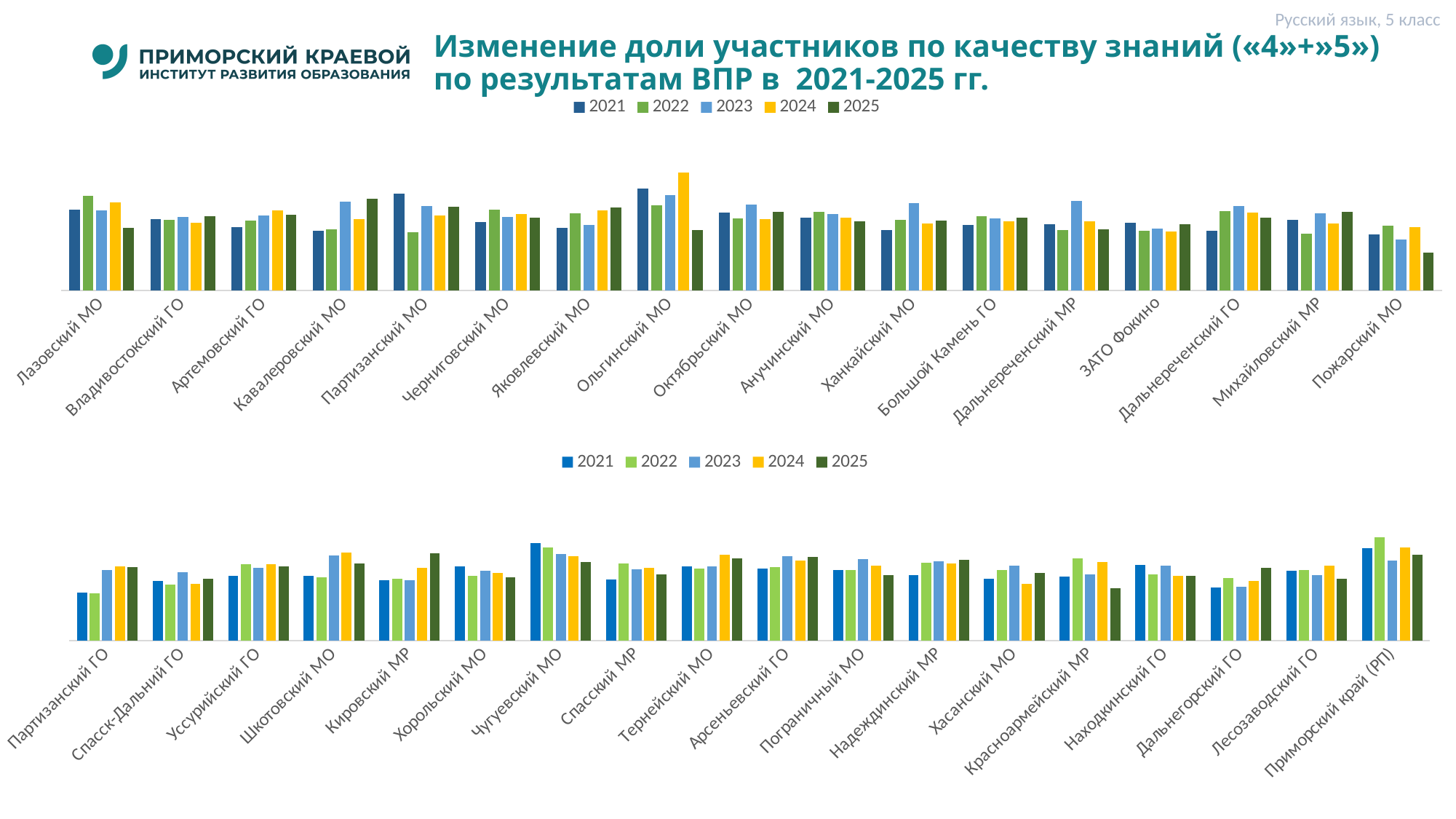
In the bottom chart, which year has the highest value for Приморский край (РП)? 2022 How many categories are shown on the x axis of the top chart? 17 Which years are listed in the legend of the bottom chart? 2021, 2022, 2023, 2024, 2025 In the top chart, which category has the tallest bar overall? Ольгинский МО What kind of chart is the top chart on the slide? bar chart How many categories are shown on the x axis of the bottom chart? 18 In the bottom chart, do the values for Чугуевский МО rise or fall from 2021 to 2025? fall In the top chart, which year has the highest value for Ольгинский МО? 2024 In the top chart, which year has the lowest value for Партизанский МО? 2022 In the top chart, which year has the lowest value for Пожарский МО? 2025 How many series does the legend of the top chart list? 5 In the bottom chart, which year has the lowest value for Красноармейский МР? 2025